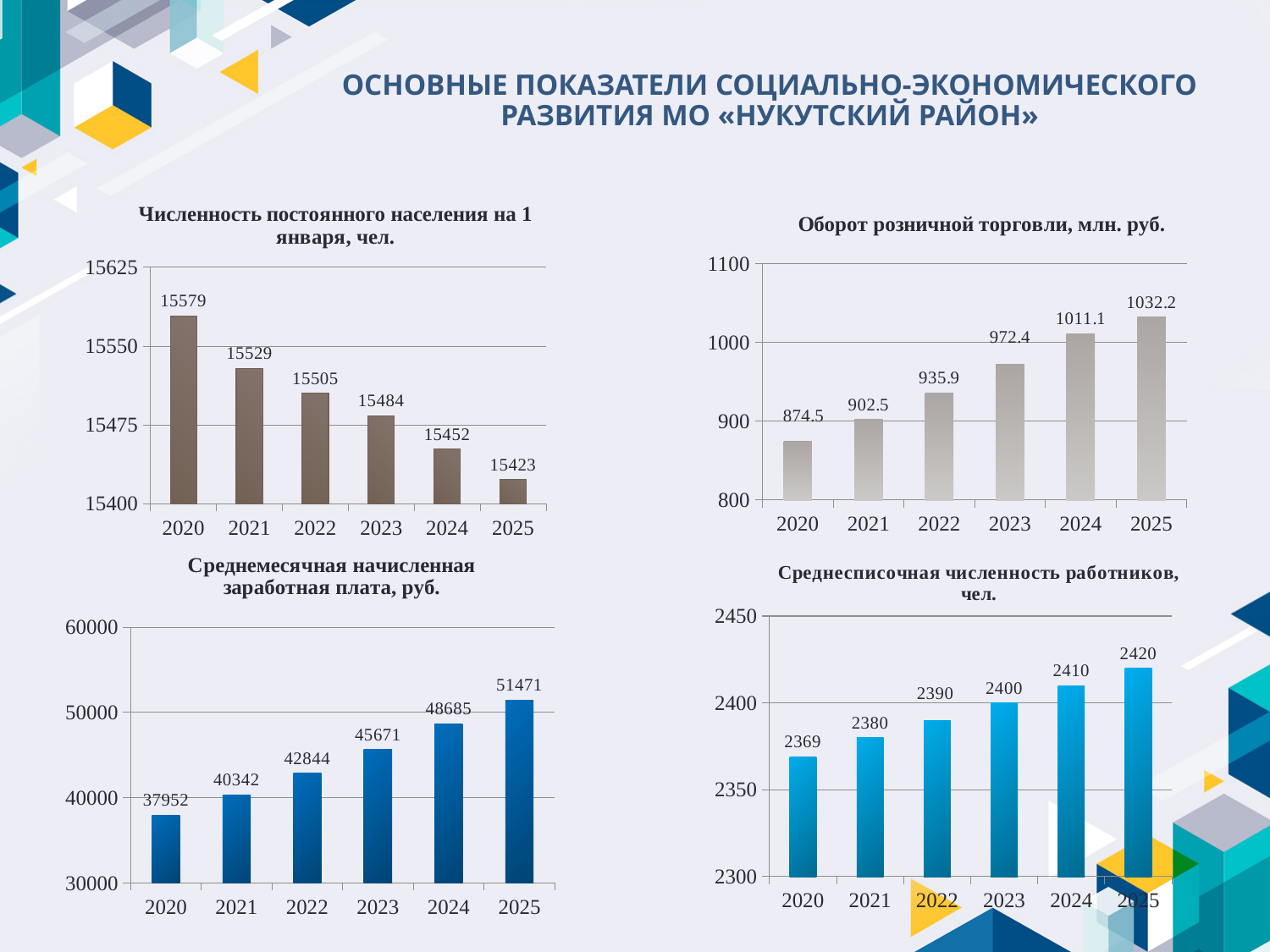
In the chart titled "Среднемесячная начисленная заработная плата, руб.", is the value for 2025 greater or less than 50000? greater In the chart titled "Среднемесячная начисленная заработная плата, руб.", what is the value for 2021? 40342 In the chart titled "Среднесписочная численность работников, чел.", what is the value for 2020? 2369 In the chart titled "Численность постоянного населения на 1 января, чел.", what is the value for 2022? 15505 What kind of chart is the one titled "Среднесписочная численность работников, чел."? bar chart In the chart titled "Оборот розничной торговли, млн. руб.", which year has the highest value? 2025 In the chart titled "Среднесписочная численность работников, чел.", which is larger, the value for 2022 or the value for 2024? 2024 In the chart titled "Оборот розничной торговли, млн. руб.", what is the value for 2023? 972.4 In the chart titled "Оборот розничной торговли, млн. руб.", what is the difference between the 2025 and 2020 values? 157.7 In the chart titled "Численность постоянного населения на 1 января, чел.", do the values rise or fall from 2020 to 2025? fall In the chart titled "Среднемесячная начисленная заработная плата, руб.", how many years are plotted? 6 In the chart titled "Численность постоянного населения на 1 января, чел.", which year has the lowest value? 2025